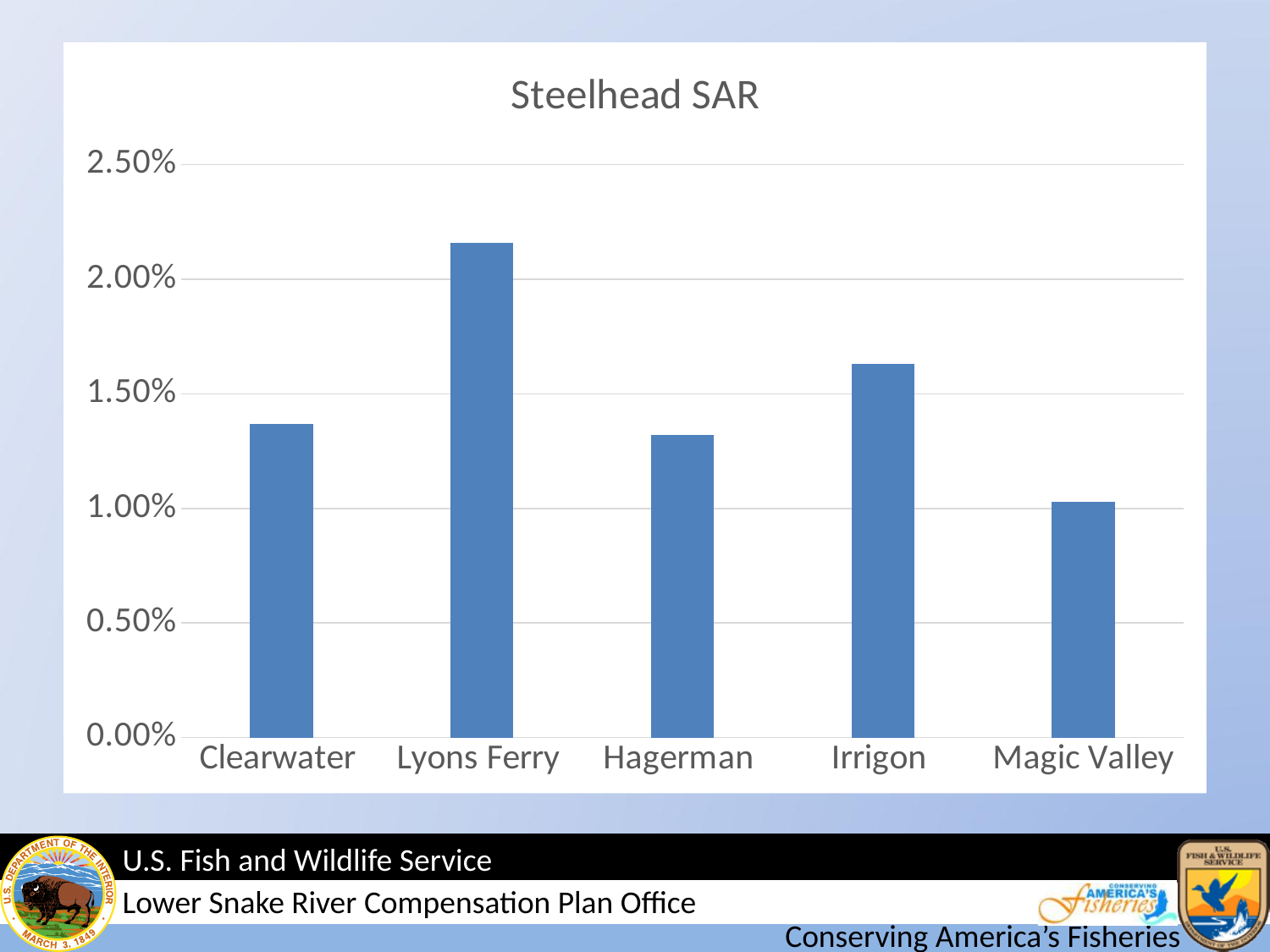
Is the value for Clearwater greater or less than 1.50%? less Which is larger, the value for Irrigon or the value for Hagerman? Irrigon Is the value for Hagerman greater or less than 1.00%? greater Is the value for Irrigon greater or less than 1.50%? greater Which hatchery has the lowest Steelhead SAR? Magic Valley What is the title of the chart? Steelhead SAR Which hatchery has the highest Steelhead SAR? Lyons Ferry What kind of chart is shown on the slide? bar chart Which is larger, the value for Lyons Ferry or the value for Clearwater? Lyons Ferry How many hatcheries (categories) are shown on the x axis? 5